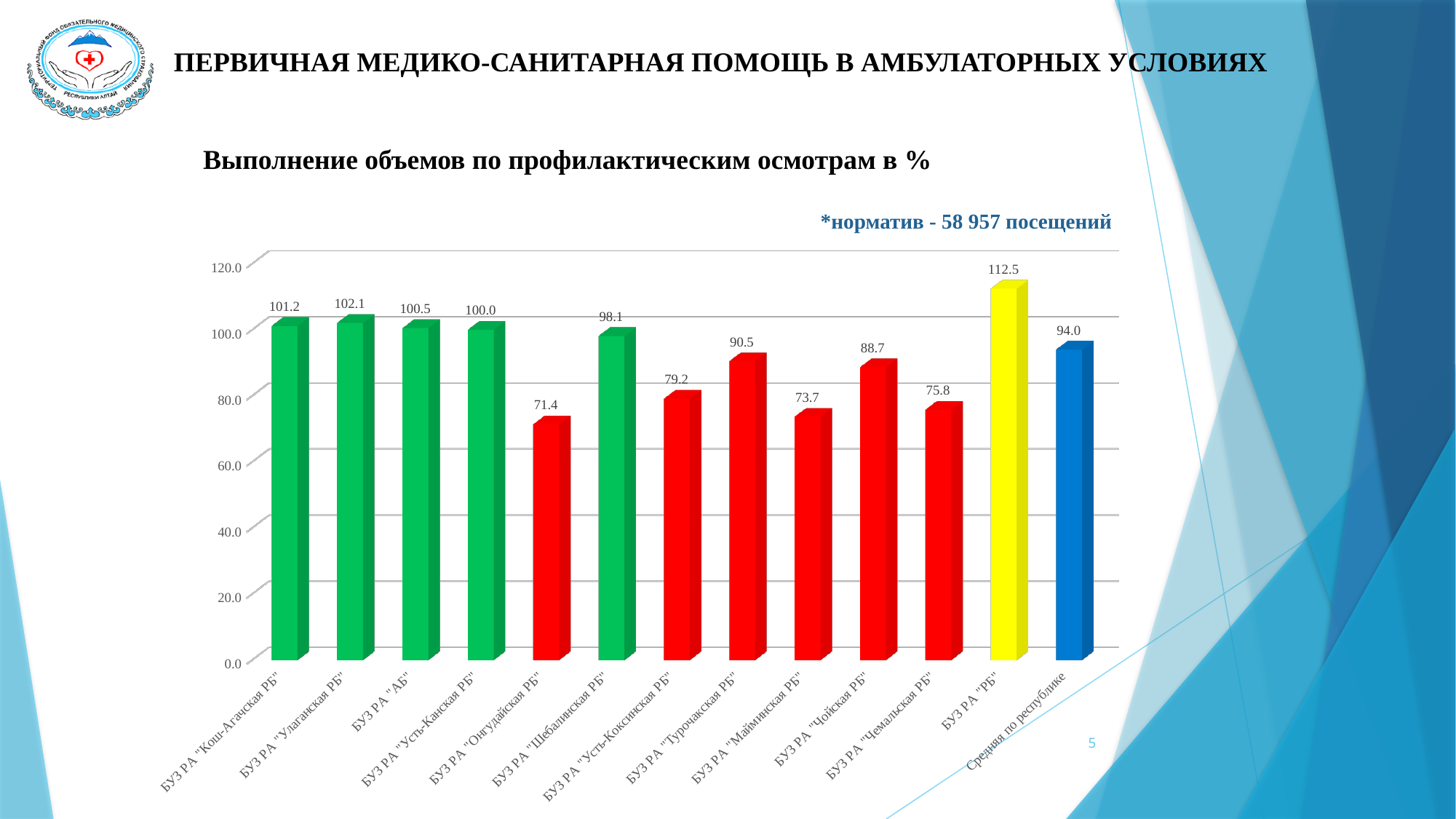
What is the value for БУЗ РА "Турочакская РБ"? 90.5 Which is larger, the value for БУЗ РА "Чойская РБ" or БУЗ РА "Усть-Коксинская РБ"? БУЗ РА "Чойская РБ" What is the value for БУЗ РА "Шебалинская РБ"? 98.1 Which category has the lowest value? БУЗ РА "Онгудайская РБ" What is the value for БУЗ РА "Онгудайская РБ"? 71.4 How many bars are plotted in the chart? 13 What kind of chart is shown on the slide? bar chart Which category has the highest value? БУЗ РА "РБ" Is the value for БУЗ РА "Майминская РБ" greater or less than 80.0? less What is the value shown for Средняя по республике? 94.0 What is the difference between the values for БУЗ РА "РБ" and Средняя по республике? 18.5 What colour is the bar for БУЗ РА "РБ"? yellow